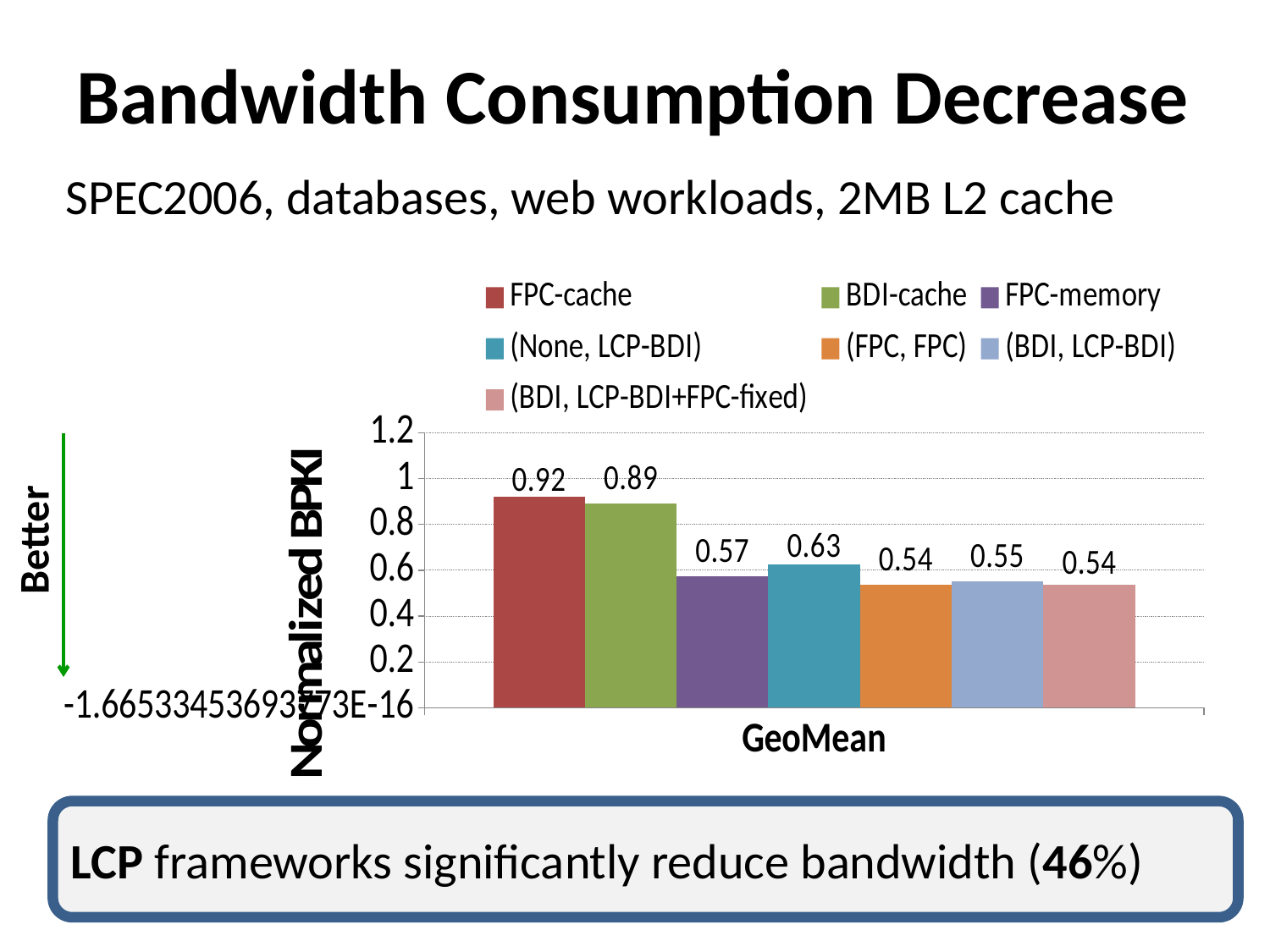
Which is larger at GeoMean: FPC-memory or (None, LCP-BDI)? (None, LCP-BDI) Which series has the highest Normalized BPKI at GeoMean? FPC-cache What is the difference between the FPC-cache and (FPC, FPC) values at GeoMean? 0.38 Is the value for BDI-cache greater or less than 0.8? greater What is the Normalized BPKI value for (None, LCP-BDI) at GeoMean? 0.63 What is the Normalized BPKI value for FPC-cache at GeoMean? 0.92 What is the Normalized BPKI value for FPC-memory at GeoMean? 0.57 What kind of chart is shown on the slide? bar chart What is the label on the vertical axis of the chart? Normalized BPKI What is the Normalized BPKI value for (BDI, LCP-BDI) at GeoMean? 0.55 How many series does the legend list? 7 What is the Normalized BPKI value for BDI-cache at GeoMean? 0.89